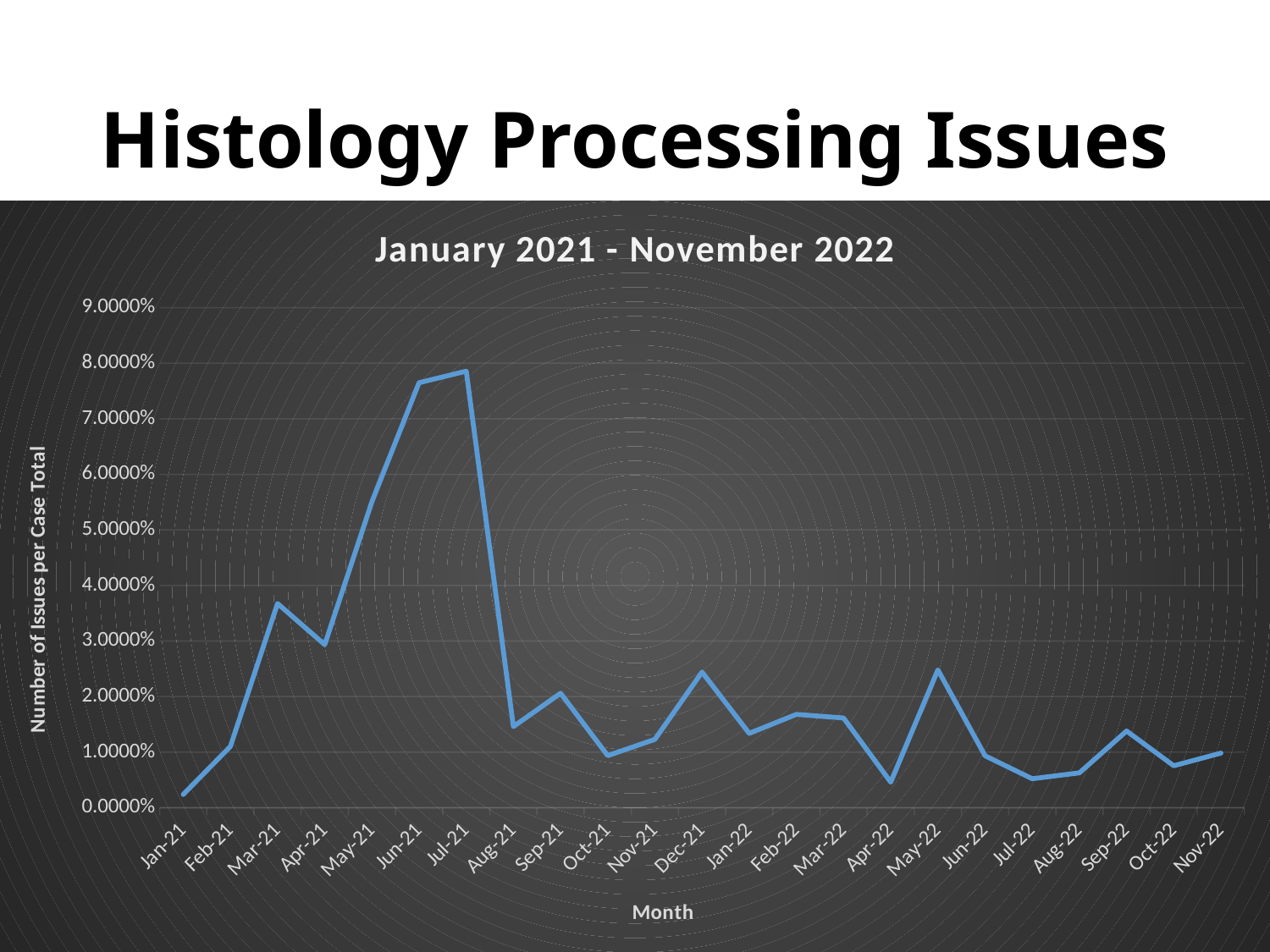
What kind of chart is shown on the slide? Line chart How many months are plotted on the x axis? 23 What is the label of the vertical axis? Number of Issues per Case Total Is the value for Jun-21 greater or less than 7.0000%? greater Which is larger, the value for Mar-21 or the value for Apr-21? Mar-21 Is the value for Apr-22 greater or less than 1.0000%? less Which month has the highest value? Jul-21 What is the title of the chart? January 2021 - November 2022 Is the value for May-22 greater or less than 2.0000%? greater Which month has the lowest value? Jan-21 Does the value rise or fall from Jul-21 to Aug-21? fall